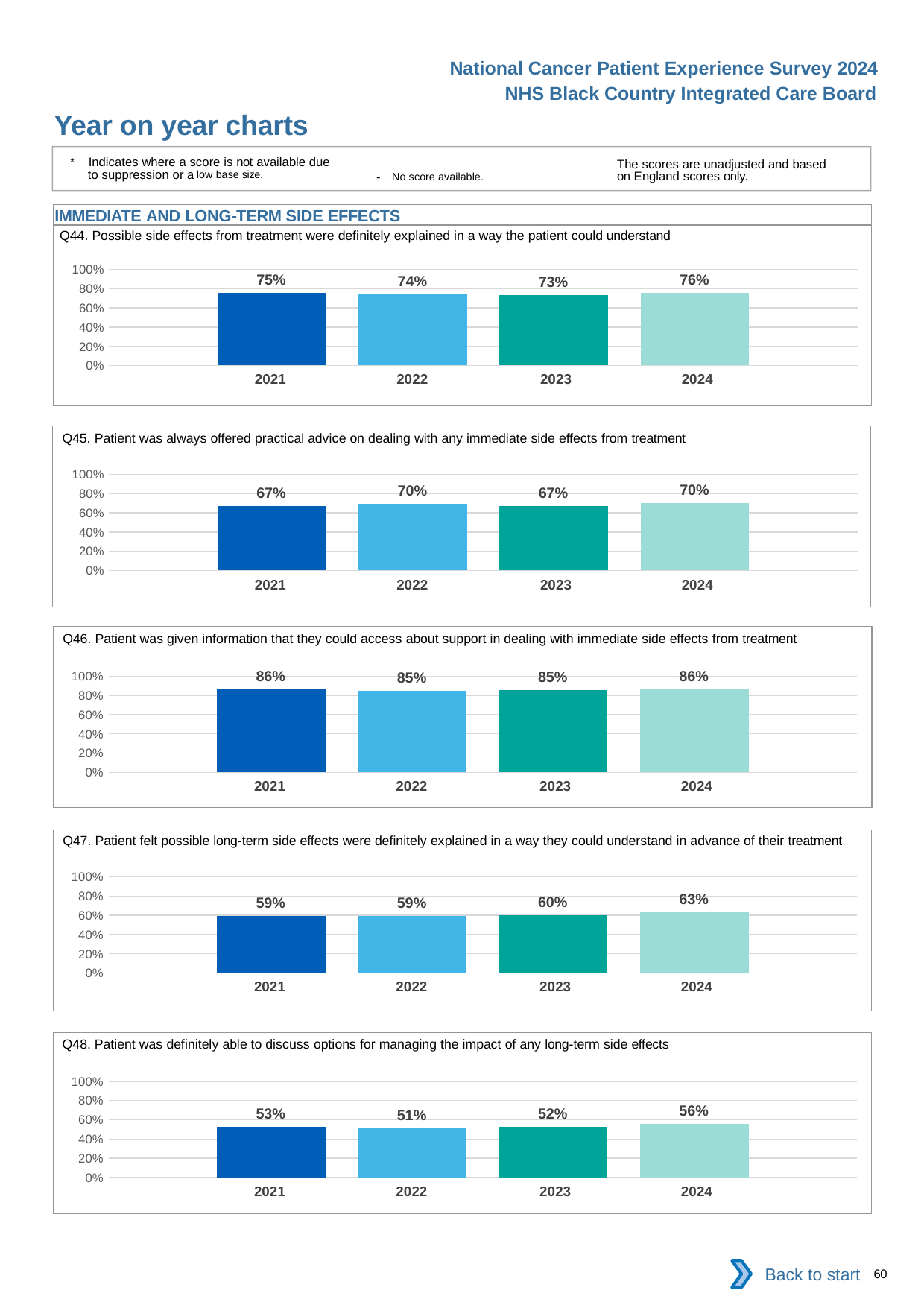
In the Q44 chart, what is the value for 2024? 76% In the Q47 chart, what is the difference between the 2024 and 2021 values? 4% In the Q48 chart, is the value for 2024 greater or less than 60%? less In the Q45 chart, what is the value for 2023? 67% In the Q46 chart, how many years are plotted? 4 In the Q48 chart, which is larger, the value for 2021 or the value for 2024? 2024 In the Q48 chart, which year has the lowest value? 2022 In the Q47 chart, which year has the highest value? 2024 In the Q46 chart, what is the value for 2022? 85% In the Q45 chart, what is the difference between the 2022 and 2021 values? 3% What kind of chart is the Q44 chart? bar chart In the Q44 chart, which year has the lowest value? 2023